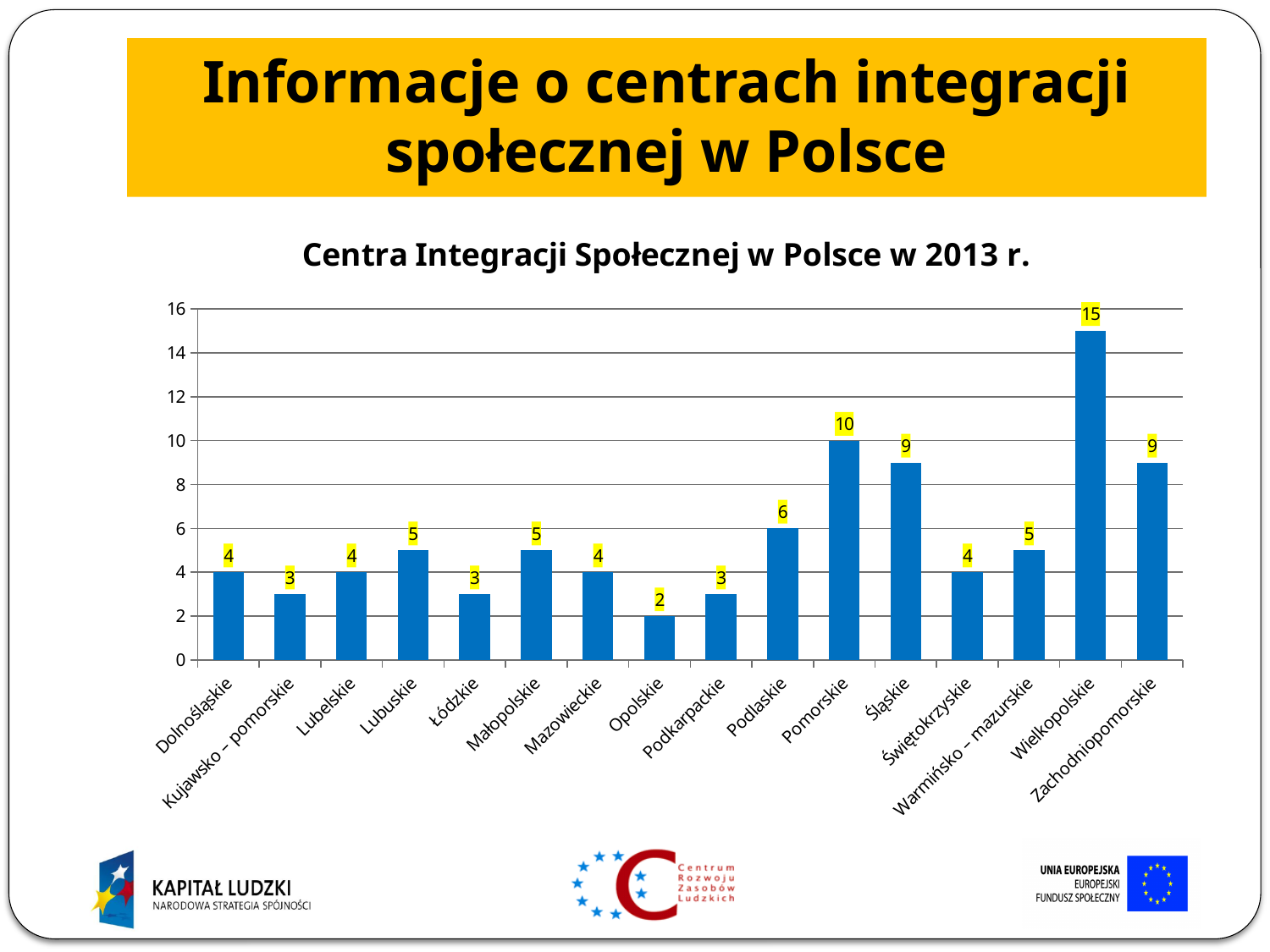
What is the title of the chart? Centra Integracji Społecznej w Polsce w 2013 r. What kind of chart is this? bar chart How many categories are shown on the x axis? 16 Which is larger, the value for Podlaskie or the value for Lubuskie? Podlaskie What is the value for Pomorskie? 10 Which category has the highest value? Wielkopolskie What is the value for Wielkopolskie? 15 Is the value for Śląskie greater or less than 8? greater What is the difference between the values for Wielkopolskie and Pomorskie? 5 What is the value for Opolskie? 2 What is the value for Zachodniopomorskie? 9 Which category has the lowest value? Opolskie